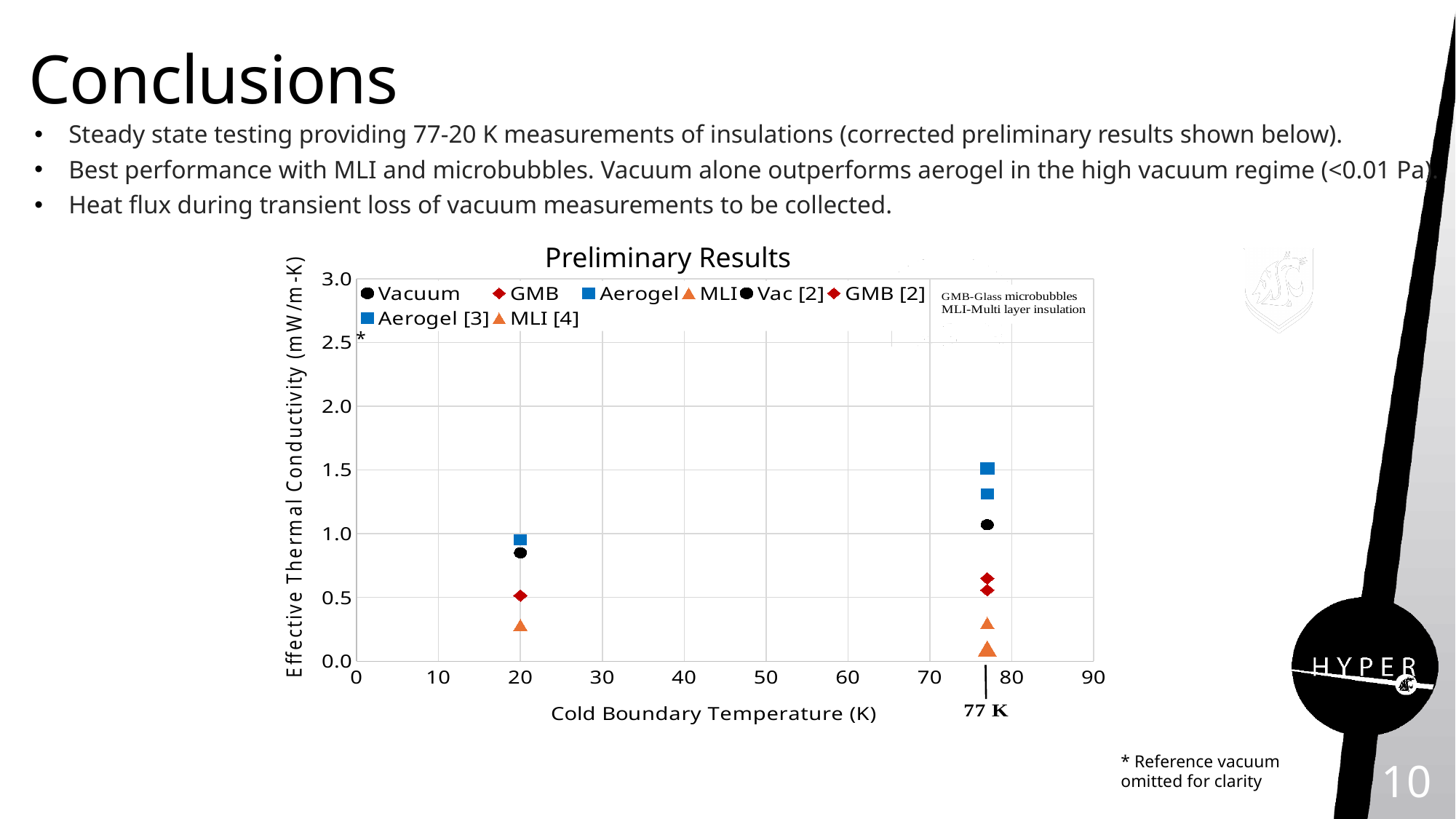
Is the highest Aerogel value near 77 K greater or less than 1.0? greater What is the title of the chart on the slide? Preliminary Results Is the MLI value at a cold boundary temperature of 20 K greater or less than 0.5? less What kind of chart is shown under the title "Preliminary Results"? scatter plot Which insulation has the lowest effective thermal conductivity at a cold boundary temperature of 20 K? MLI At a cold boundary temperature of 20 K, which has the larger effective thermal conductivity, Aerogel or GMB? Aerogel What is the label of the x axis of the chart? Cold Boundary Temperature (K) Is the highest plotted value on the chart greater or less than 2.0? less How many series does the legend of the Preliminary Results chart list? 8 At a cold boundary temperature of 20 K, which has the larger effective thermal conductivity, Vacuum or MLI? Vacuum Do the plotted effective thermal conductivity values rise or fall as the cold boundary temperature increases from 20 K to about 77 K? rise